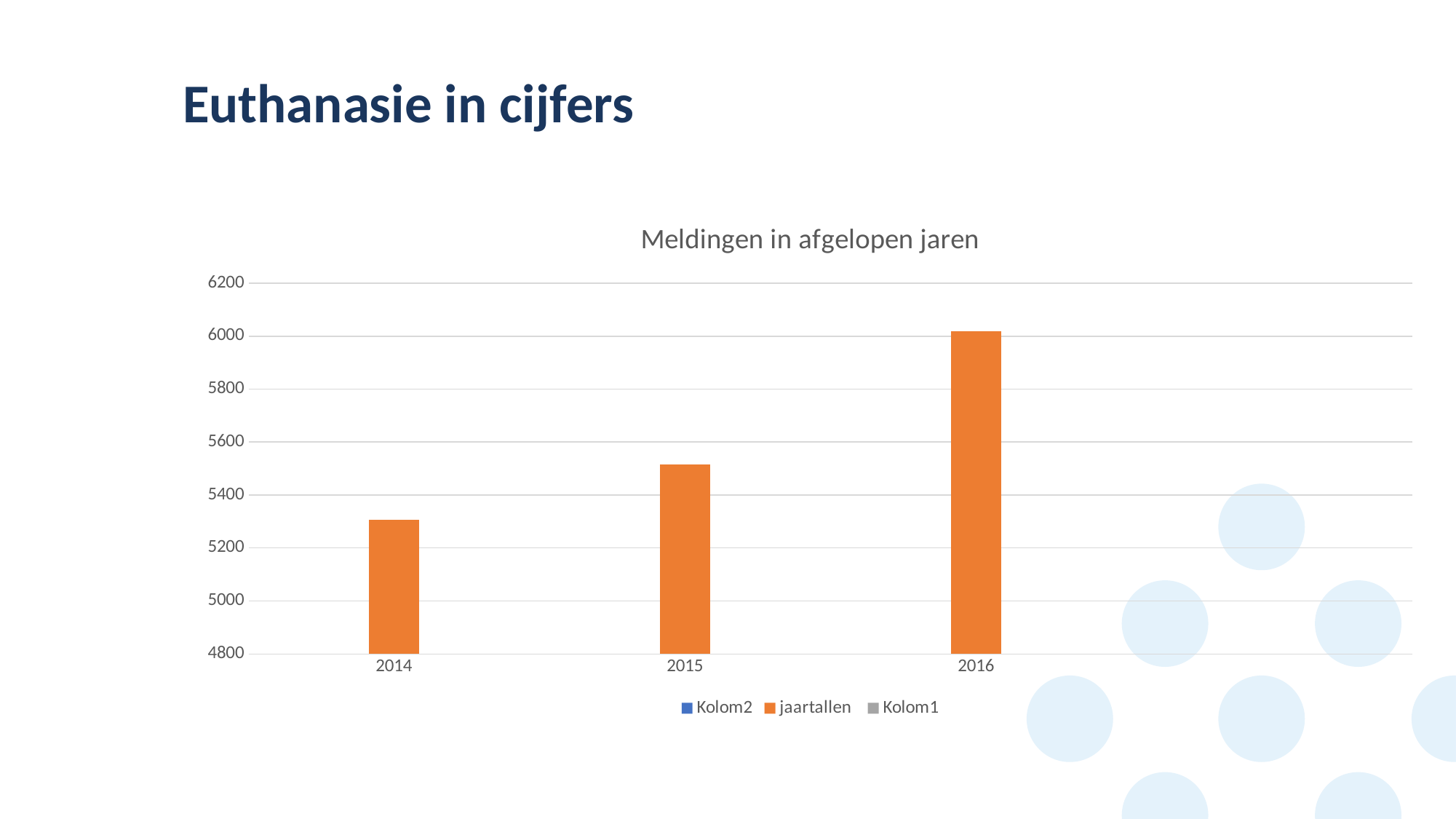
Which legend entry corresponds to the orange bars? jaartallen Which is larger, the value for 2015 or the value for 2014? 2015 How many years are shown on the x axis of the chart? 3 Which year has the lowest bar in the chart? 2014 Which year has the highest bar in the chart? 2016 Do the values rise or fall from 2014 to 2016? rise What kind of chart is shown on the slide? bar chart How many series does the chart legend list? 3 What is the title of the chart? Meldingen in afgelopen jaren Is the value for 2015 greater or less than 5400? greater Is the value for 2014 greater or less than 5400? less